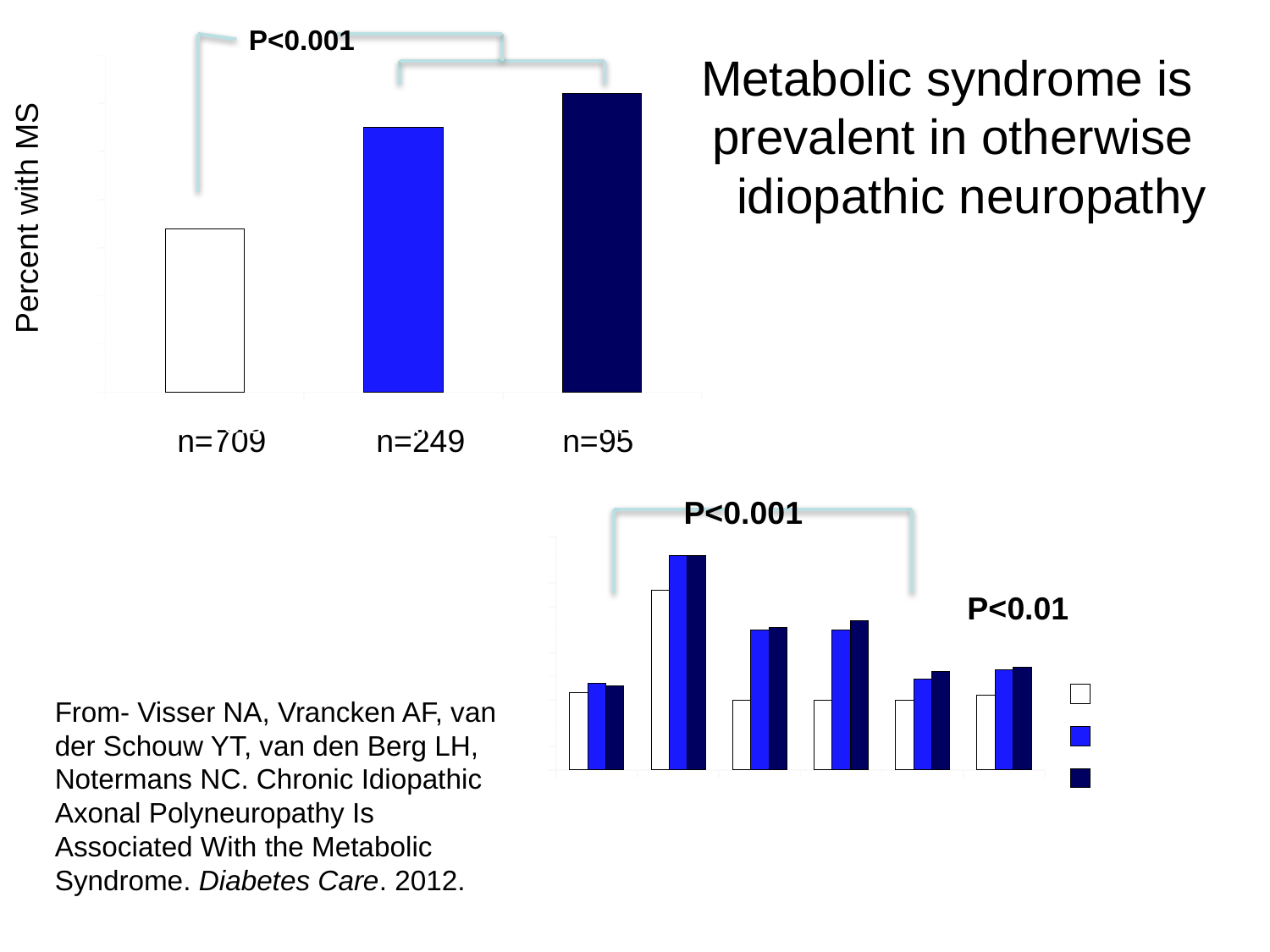
In the top chart, which group has the lowest percent with MS? n=709 What P value is shown above the top chart comparing the n=709 group with the other groups? P<0.001 In the bottom chart, which group of bars (counting from the left) has the tallest bars? the second group How many groups of bars are plotted in the bottom chart? 6 In the top chart, which group has a higher percent with MS, n=95 or n=249? n=95 In the top chart, which group has a higher percent with MS, n=249 or n=709? n=249 In the top chart, which group has the highest percent with MS? n=95 How many bars are plotted in the top chart? 3 How many series does the legend of the bottom chart list? 3 What is the y-axis label of the top chart? Percent with MS What kind of chart is the top chart on the slide? bar chart What kind of chart is the bottom chart on the slide? bar chart